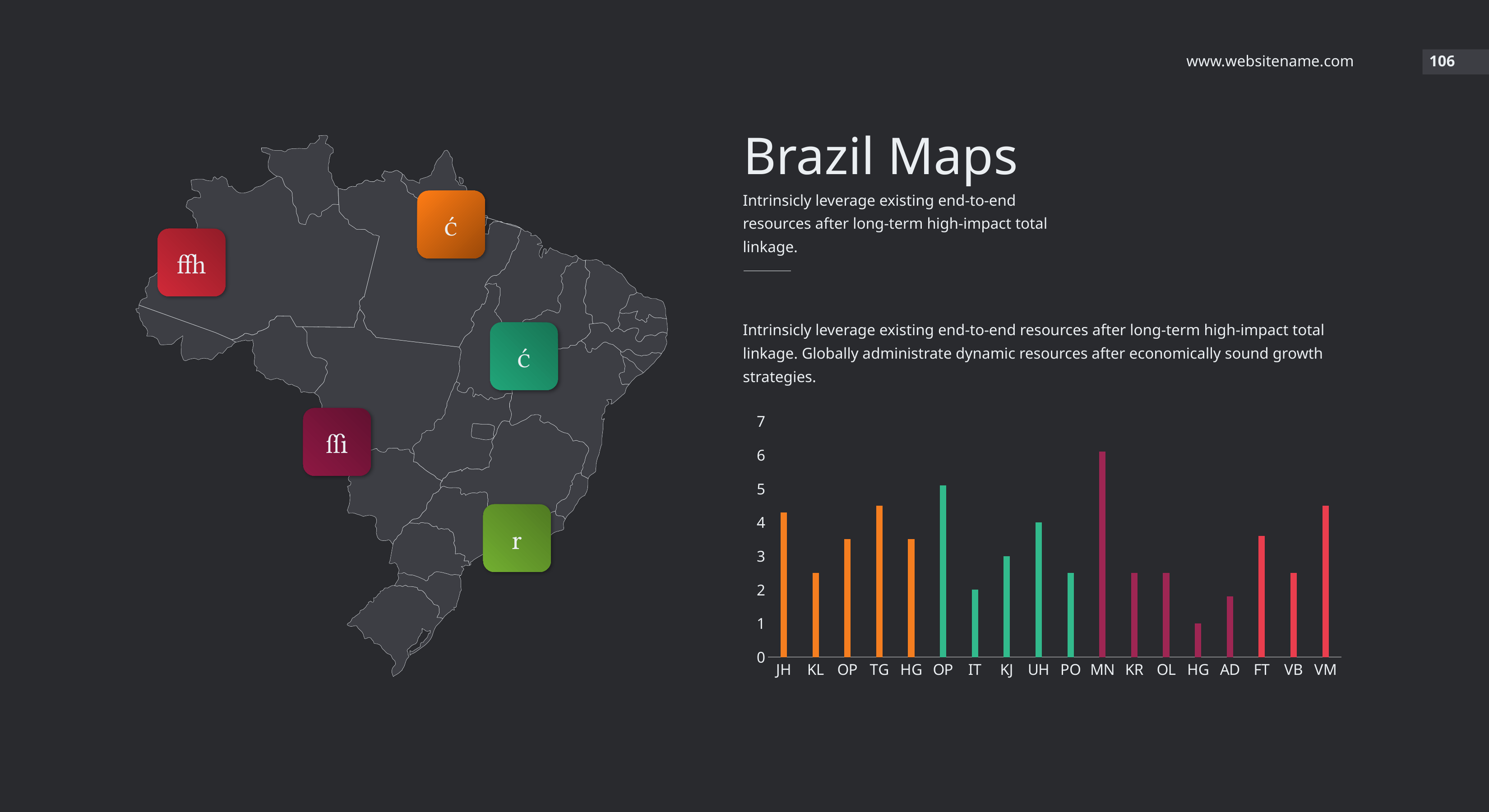
Is the value for KL greater or less than 3? less What is the highest value shown on the chart's vertical axis? 7 Is the value for MN greater or less than 5? greater How many bars are plotted in the chart? 18 What colour are the bars for JH, KL, OP, TG and HG at the left of the chart? orange Which is larger, the value for TG or the value for IT? TG Which is larger, the value for MN or the value for KL? MN Which category has the lowest bar in the chart? HG (the second HG, between OL and AD) Which category has the highest bar in the chart? MN What kind of chart is shown on the slide? bar chart Is the value for UH greater or less than 3? greater